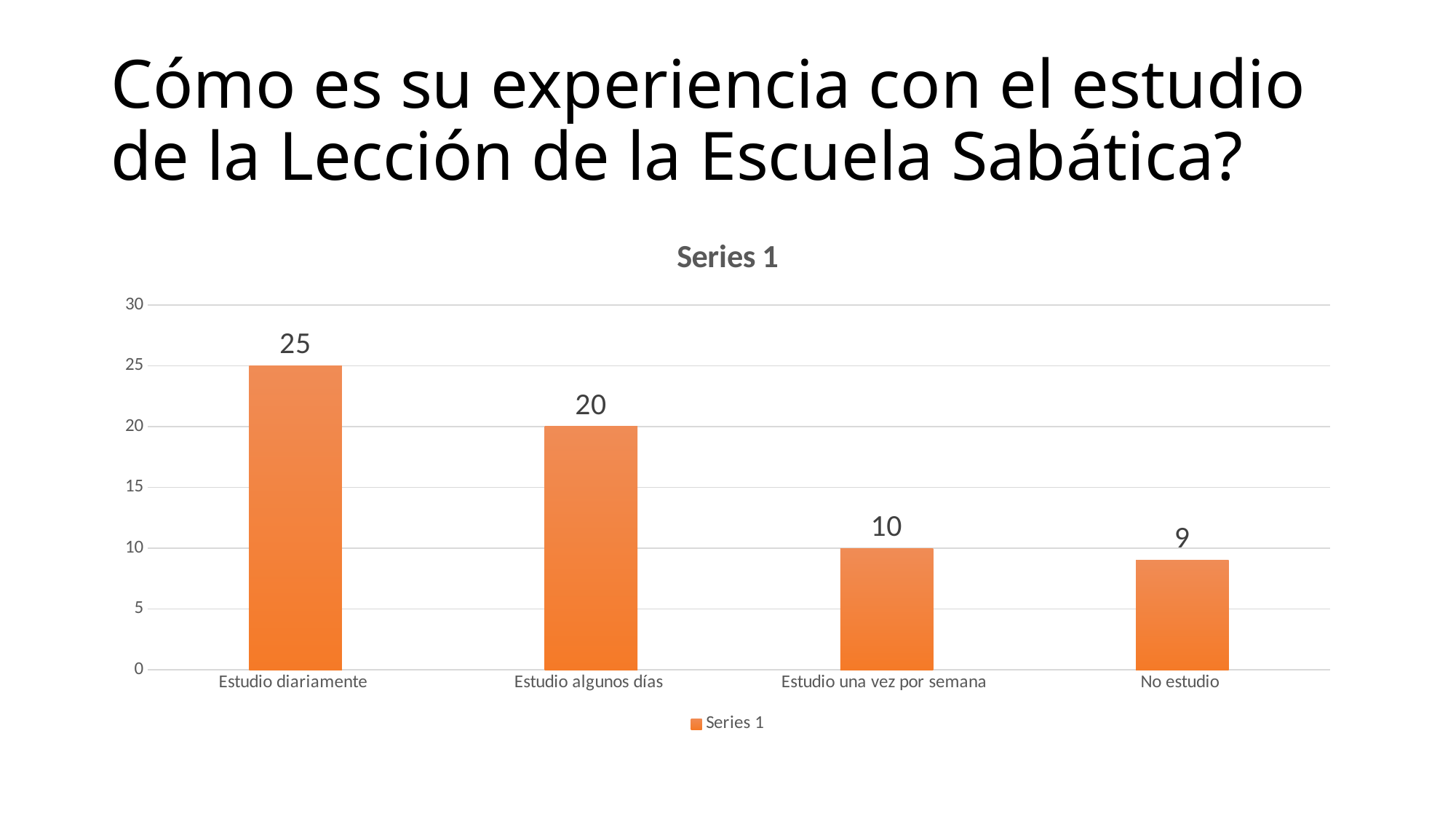
What is the value for Estudio diariamente? 25 Do the values rise or fall from left to right along the x axis? fall What is the value for No estudio? 9 Is the value for No estudio greater or less than 10? less How many categories are shown on the x axis? 4 What is the difference between the values for Estudio diariamente and Estudio algunos días? 5 Which is larger, the value for Estudio algunos días or the value for Estudio una vez por semana? Estudio algunos días What is the value for Estudio algunos días? 20 Which category has the lowest value? No estudio What kind of chart is shown on the slide? bar chart Which category has the highest value? Estudio diariamente What is the value for Estudio una vez por semana? 10